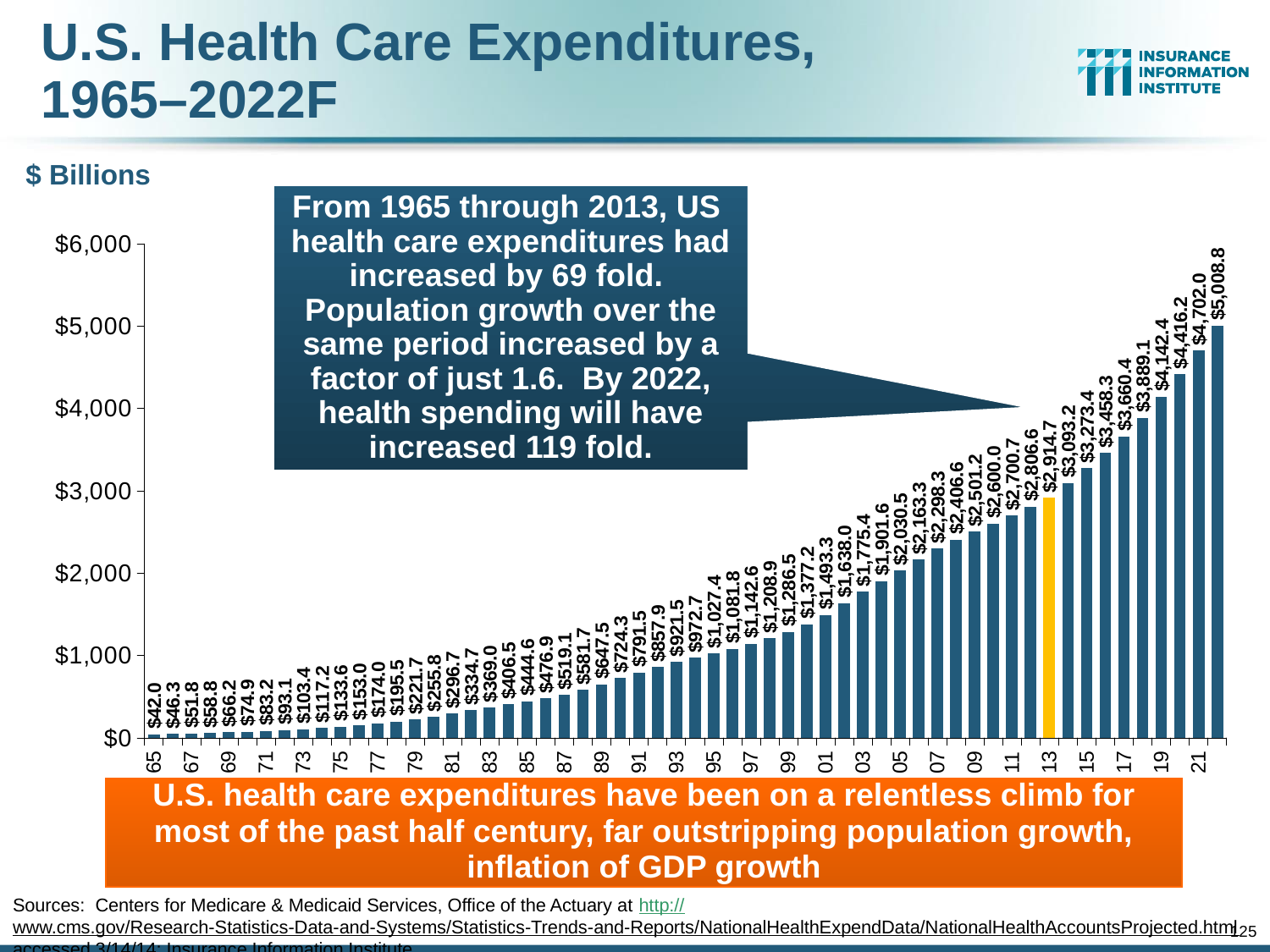
What is the difference between the 1975 value and the 1965 value? $91.6 What is the difference between the 2022 value and the 2013 value? $2,094.1 Which is larger, the value for 1990 or the value for 2000? 2000 Which year has the highest expenditure? 2022 ($5,008.8) Which year has the lowest expenditure? 1965 ($42.0) Do the values rise or fall from 1965 to 2022? Rise Is the value for 2010 greater or less than $2,000? greater What is the value for 1965? $42.0 What is the value for 2013 (the highlighted bar)? $2,914.7 How many years (bars) are plotted in the chart? 58 What is the value for 2000? $1,377.2 What kind of chart is shown? Bar chart